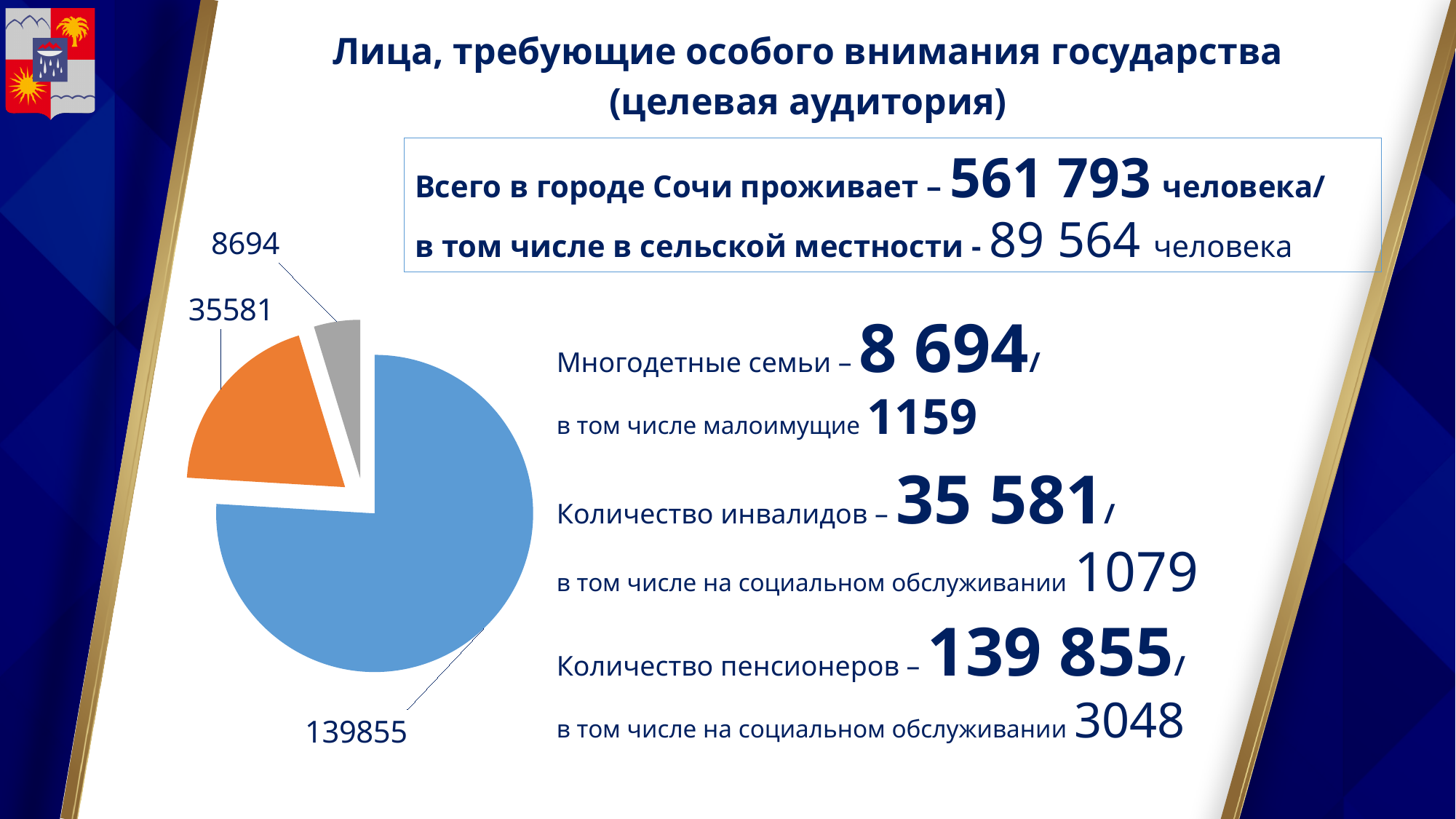
How many slices does the pie chart have? 3 What is the value shown for the gray slice of the pie chart? 8694 Which slice is larger: the orange slice or the gray slice? the orange slice What colour is the largest slice of the pie chart? blue What kind of chart is shown on the slide? pie chart What is the value of the smallest slice of the pie chart? 8694 What is the value shown for the orange slice of the pie chart? 35581 What is the difference between the orange slice (35581) and the gray slice (8694)? 26887 What is the difference between the largest slice (139855) and the orange slice (35581)? 104274 What is the value of the largest slice of the pie chart? 139855 What is the total of all three slices in the pie chart? 184130